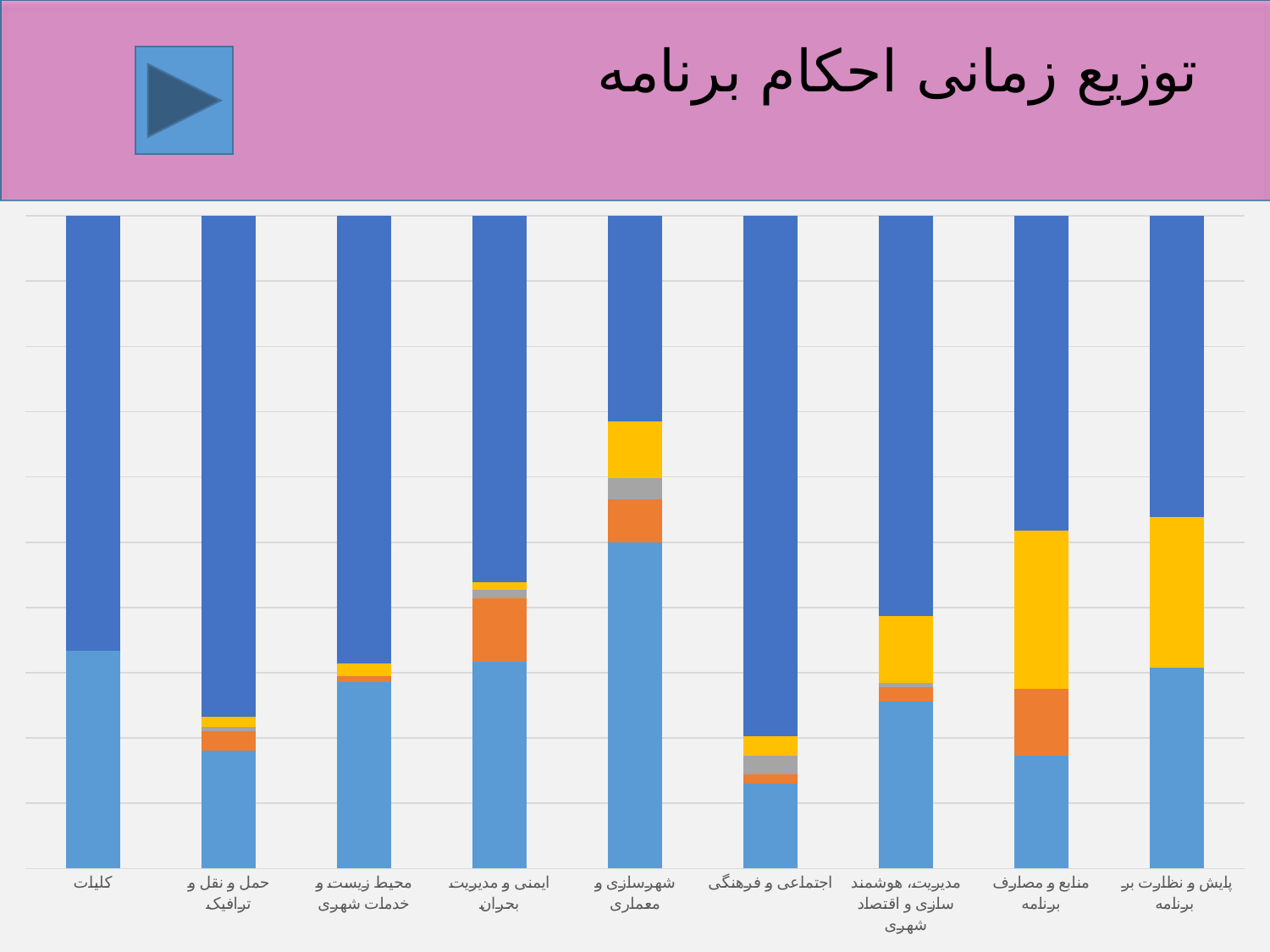
Which category has the smallest dark-blue (top) segment? شهرسازی و معماری Which category has the largest orange segment? منابع و مصارف برنامه Which category has the largest dark-blue (top) segment? اجتماعی و فرهنگی What kind of chart is shown on the slide? Stacked bar chart Which category is the leftmost on the x axis? کلیات Is the light-blue segment larger for شهرسازی و معماری or for اجتماعی و فرهنگی? شهرسازی و معماری Which category has the largest light-blue (bottom) segment? شهرسازی و معماری Is the dark-blue segment larger for حمل و نقل و ترافیک or for پایش و نظارت بر برنامه? حمل و نقل و ترافیک What is the title of the slide? توزیع زمانی احکام برنامه Which category has the smallest light-blue (bottom) segment? اجتماعی و فرهنگی How many categories are shown along the x axis of the chart? 9